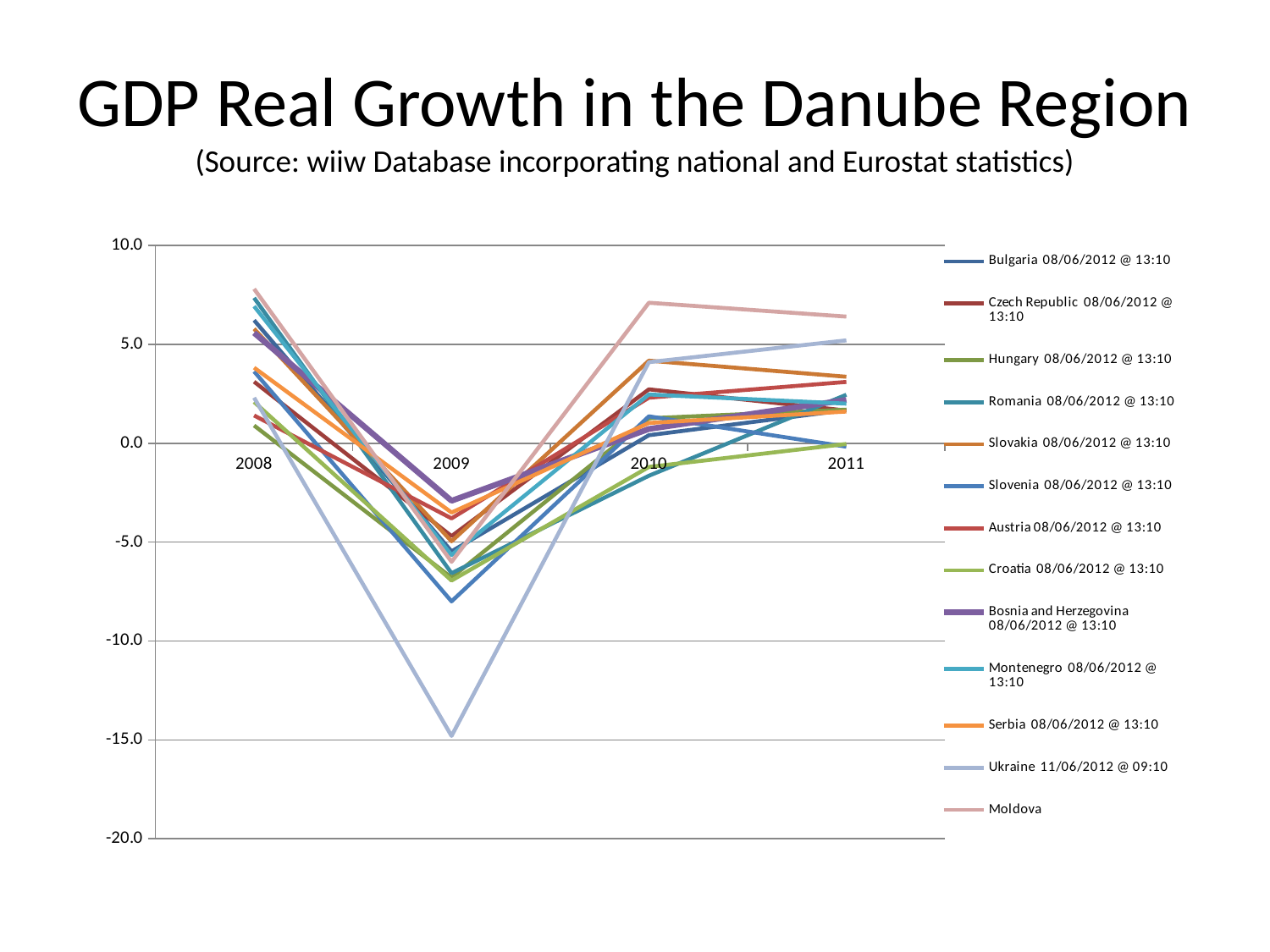
Is the value for Ukraine in 2009 greater or less than -10.0? less Is the value for Moldova in 2010 greater or less than 5.0? greater Which series has the highest value in 2010? Moldova In 2009, which is larger, the value for Moldova or the value for Ukraine? Moldova How many series does the legend list? 13 Which series has the lowest value in 2009? Ukraine Is the value for Hungary in 2009 greater or less than -5.0? less What kind of chart is shown on the slide? line chart What is the title of the chart on the slide? GDP Real Growth in the Danube Region Does the Ukraine series rise or fall from 2009 to 2011? rise Which series has the highest value in 2011? Moldova How many years are plotted along the x axis? 4